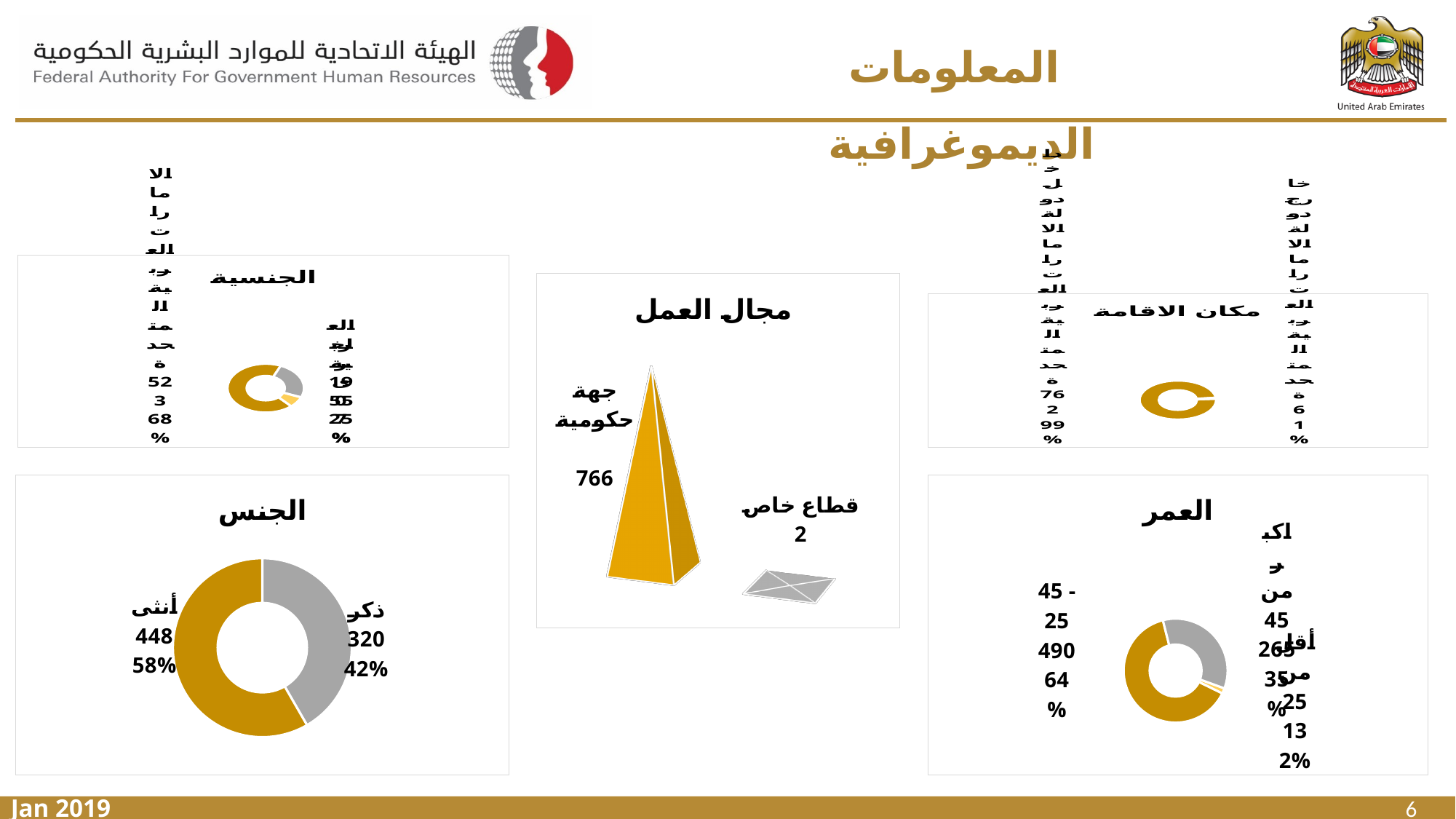
On the مجال العمل chart, what is the value for جهة حكومية? 766 On the الجنس chart, what percentage is shown for ذكر? 42% On the مجال العمل chart, what is the value for قطاع خاص? 2 What kind of chart is the الجنس chart? Donut chart On the الجنس chart, what is the difference between the values for أنثى and ذكر? 128 On the الجنس chart, what is the value for أنثى? 448 On the العمر chart, what percentage is shown for the 45 - 25 age group? 64% On the الجنس chart, what is the total of the two categories? 768 On the مجال العمل chart, which category is the highest? جهة حكومية On the العمر chart, what is the value for the 45 - 25 age group? 490 On the مجال العمل chart, how many categories are shown? 2 On the الجنس chart, which category has the larger share, أنثى or ذكر? أنثى